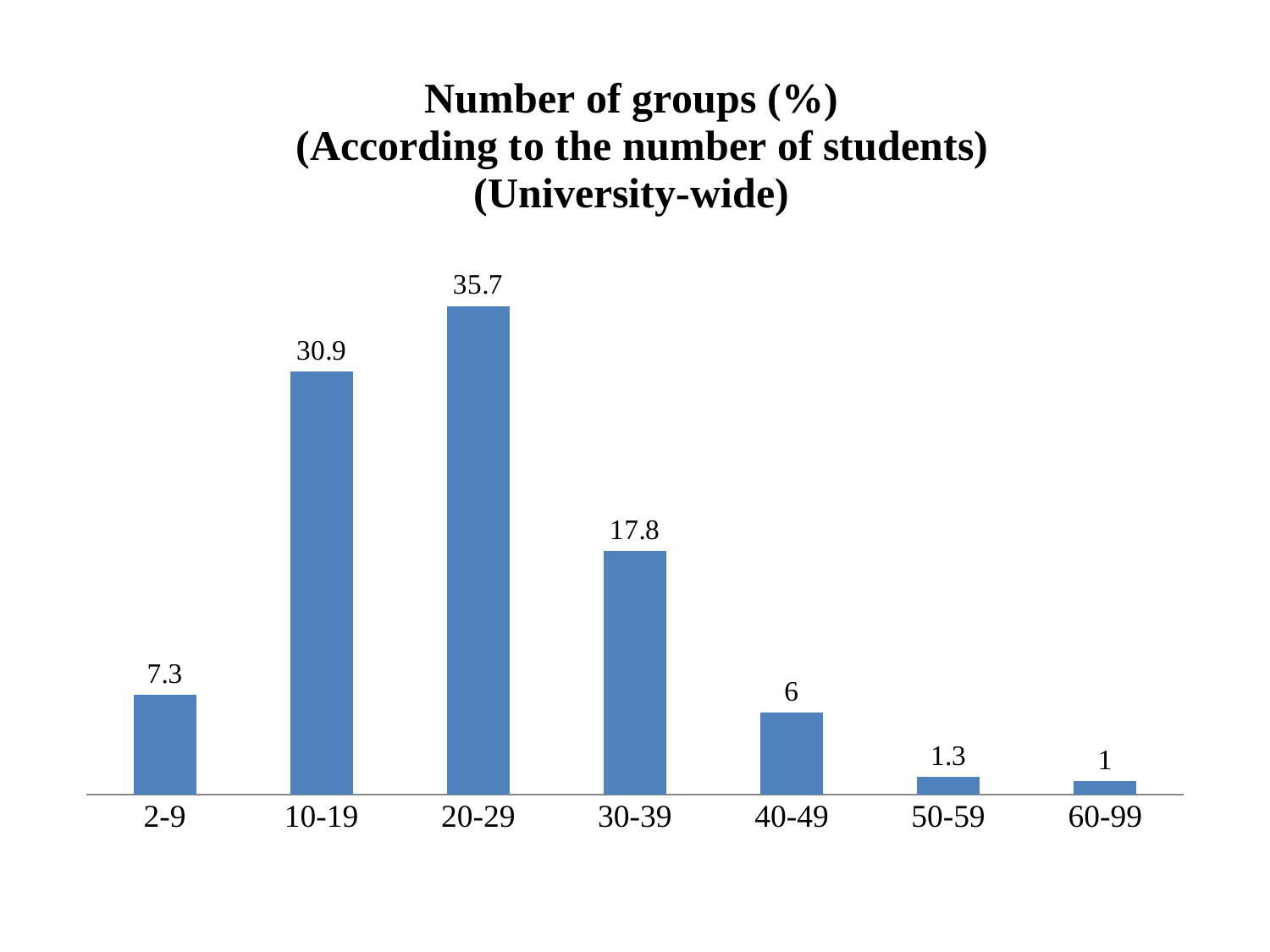
How many categories are shown on the x axis? 7 What is the difference between the values for 20-29 and 10-19? 4.8 Which is larger, the value for 10-19 or the value for 30-39? 10-19 Which category has the highest value? 20-29 What kind of chart is this? bar chart Which category has the lowest value? 60-99 Do the values rise or fall from the 20-29 category to the 60-99 category? fall What is the value for the 20-29 category? 35.7 What is the title of the chart? Number of groups (%) (According to the number of students) (University-wide) What is the value for the 2-9 category? 7.3 What is the difference between the values for 30-39 and 40-49? 11.8 What is the value for the 50-59 category? 1.3